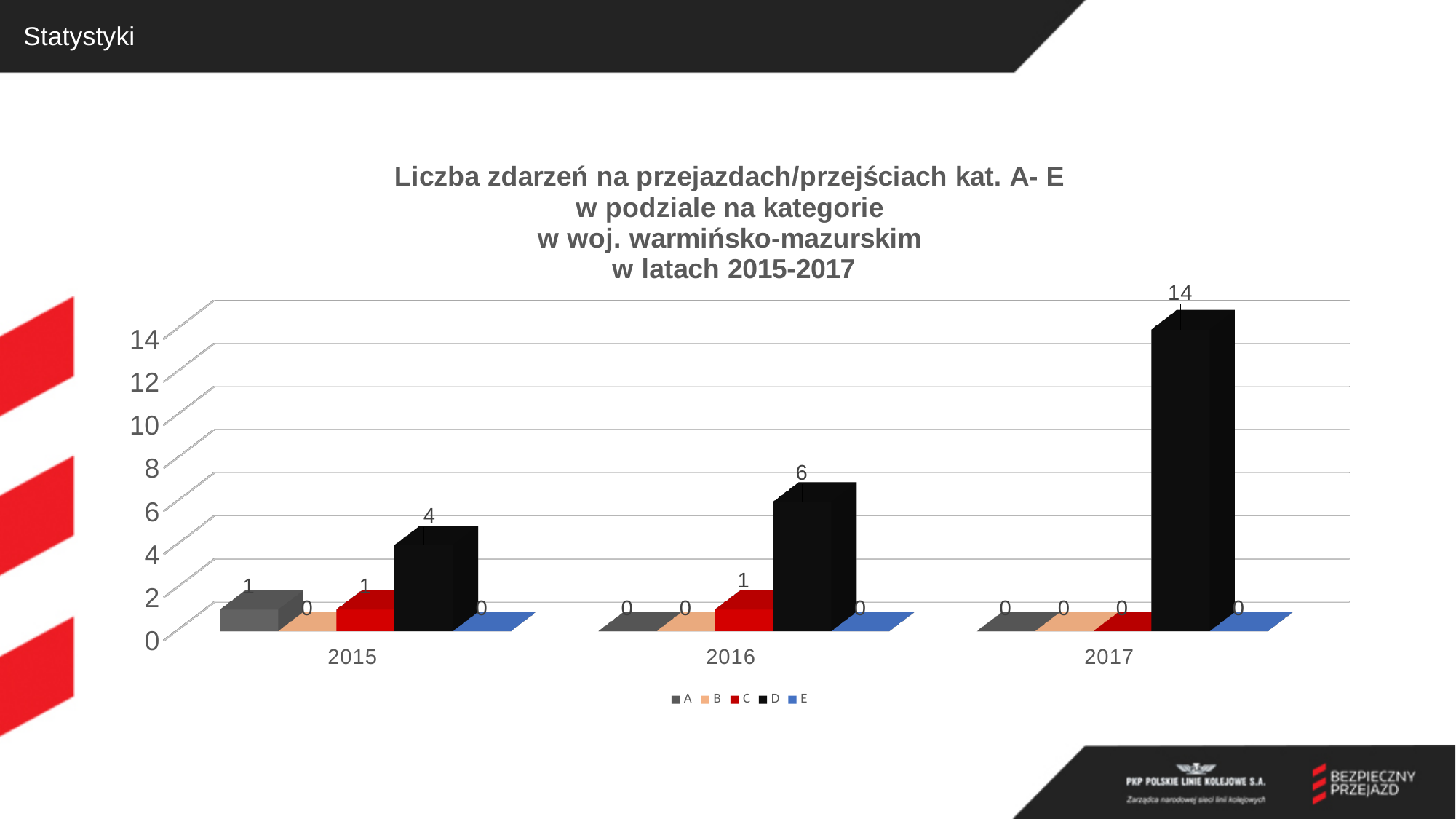
What is the value for series D in 2015? 4 What kind of chart is shown on the slide? bar chart What is the value for series A in 2015? 1 What is the value for series C in 2016? 1 How many series does the legend list? 5 What is the difference between the value for series D in 2017 and in 2016? 8 Which is larger: the value for series D in 2016 or in 2015? 2016 What is the value for series D in 2017? 14 In which year is the value for series D highest? 2017 How many years are shown on the x axis? 3 Does the value for series D rise or fall from 2015 to 2017? rise In which year is the value for series D lowest? 2015